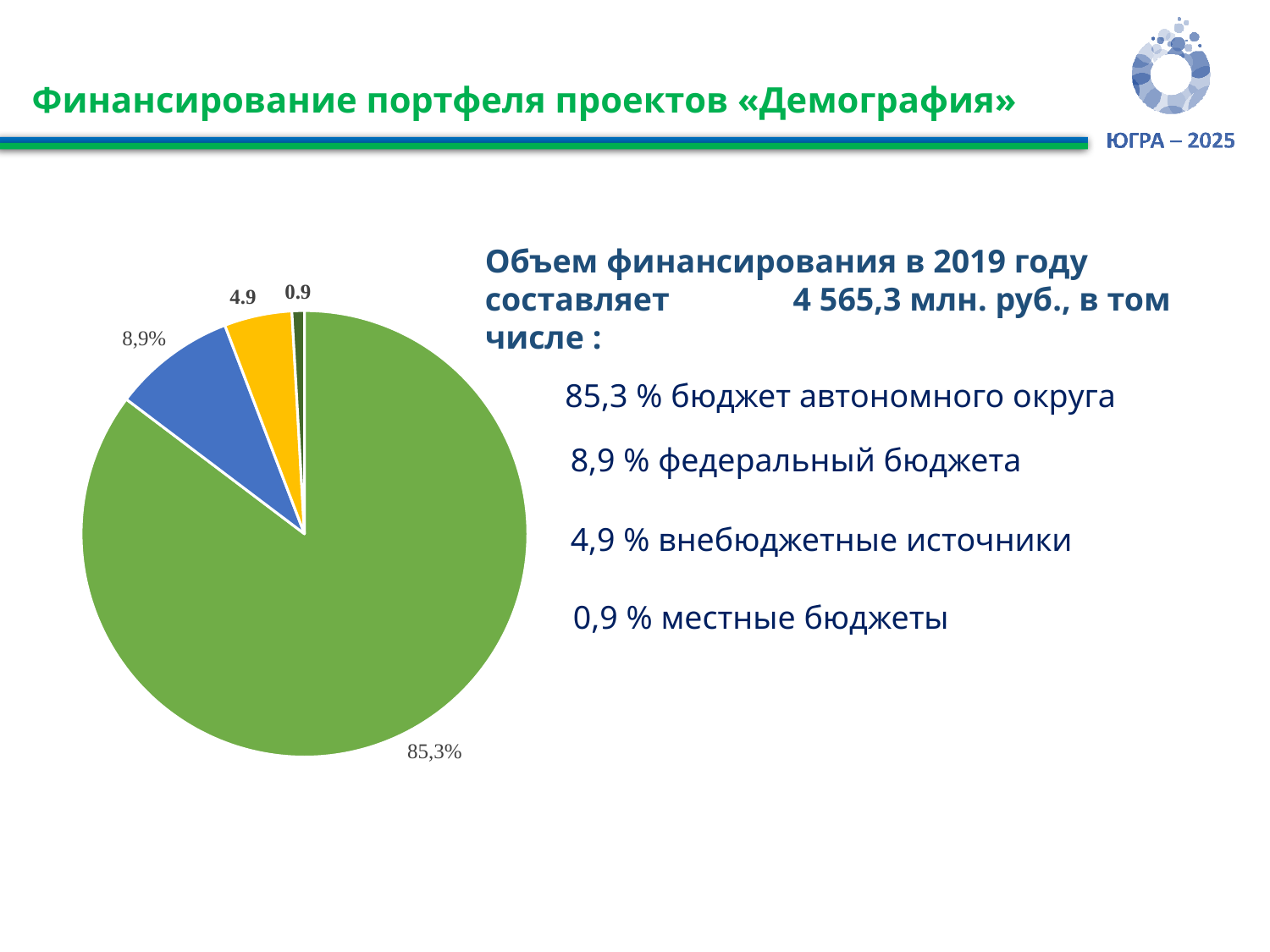
What share of the pie does the green slice (бюджет автономного округа) represent? 85,3% What colour is the largest slice of the pie chart? green Which slice is larger in the pie chart, the blue one or the yellow one? the blue one What kind of chart is shown on the slide? pie chart What is the data label on the smallest slice of the pie chart? 0.9 What is the data label on the largest slice of the pie chart? 85,3% How many slices does the pie chart have? 4 What is the difference between the 8,9% slice and the 4.9 slice? 4 What is the difference between the largest slice (85,3%) and the blue slice (8,9%)? 76,4 According to the slide, what total funding volume in 2019 does the pie chart break down? 4 565,3 млн. руб. What is the data label on the yellow slice of the pie chart? 4.9 What is the data label on the blue slice of the pie chart? 8,9%